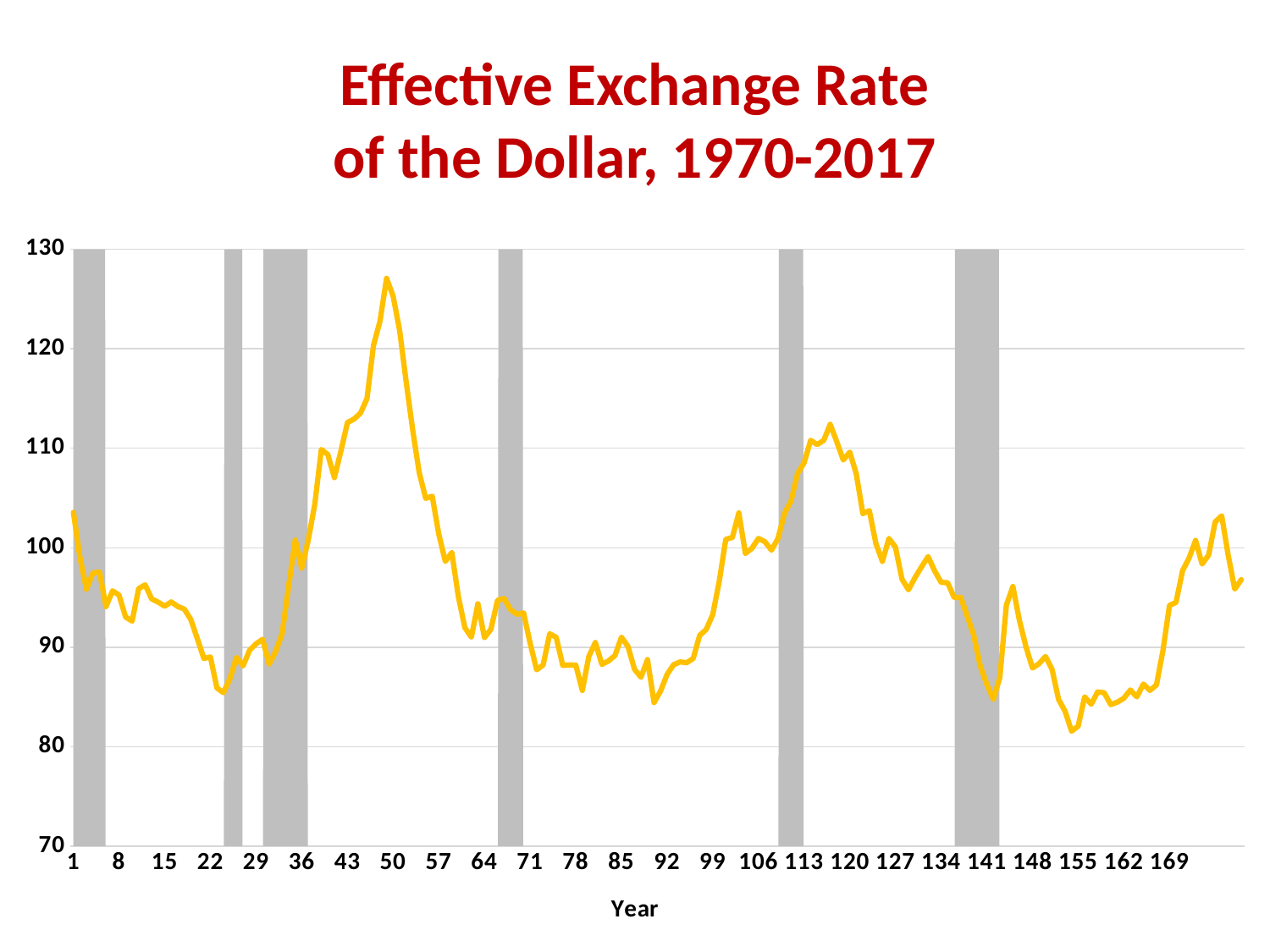
Does the line rise or fall between x = 36 and x = 50? rise Is the value of the line at x = 113 greater or less than 100? greater Is the value of the line at x = 43 greater or less than 110? greater What kind of chart is shown on the slide? line chart Is the value of the line at x = 1 greater or less than 100? greater Is the lowest point of the line greater or less than 85? less Is the highest point of the line greater or less than 120? greater What is the label on the x axis of the chart? Year What is the title of the chart? Effective Exchange Rate of the Dollar, 1970-2017